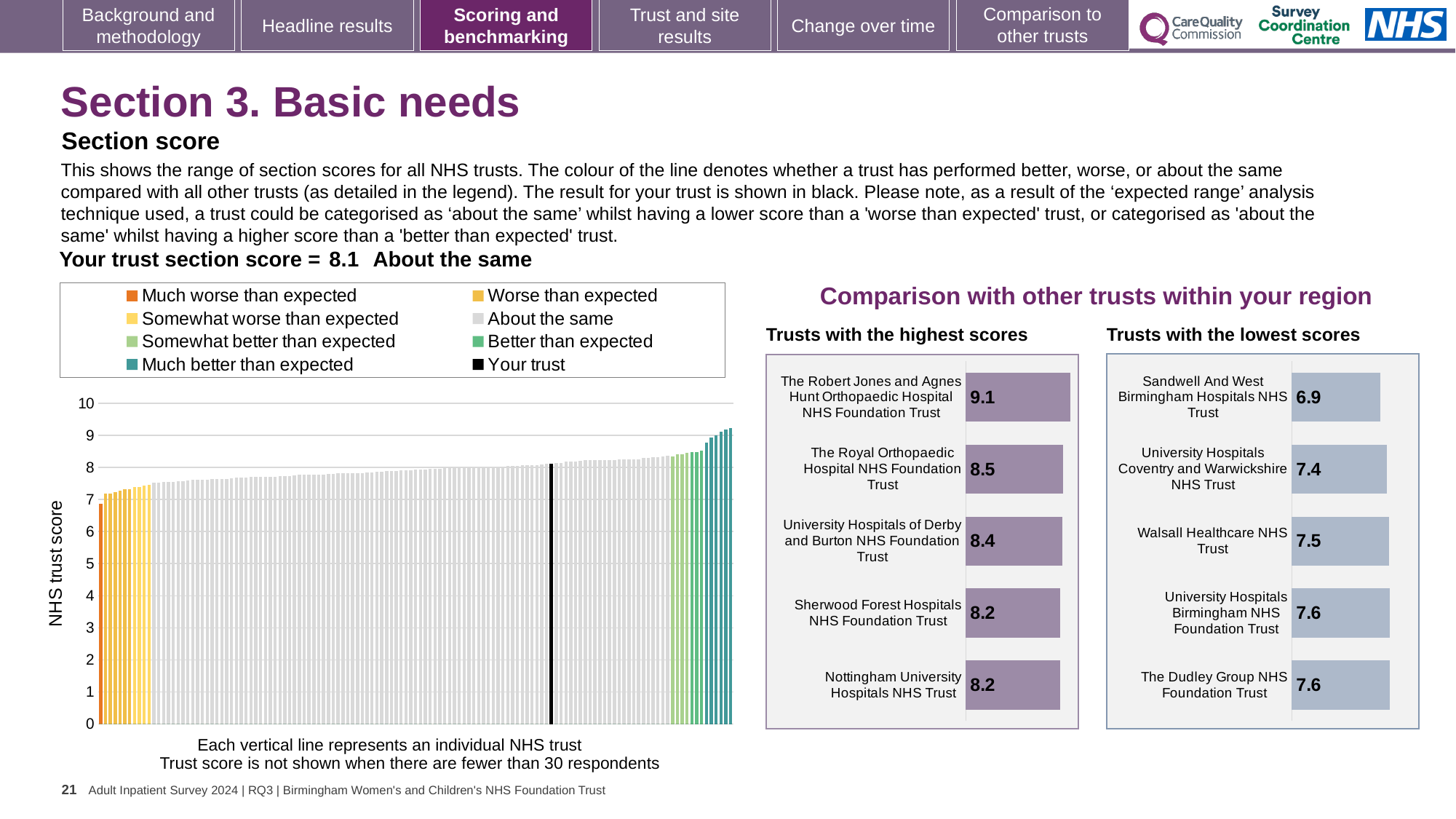
What is the difference between the score of The Robert Jones and Agnes Hunt Orthopaedic Hospital NHS Foundation Trust in the highest scores chart and Sandwell And West Birmingham Hospitals NHS Trust in the lowest scores chart? 2.2 In the 'Trusts with the lowest scores' chart, which has the higher score: Walsall Healthcare NHS Trust or University Hospitals Coventry and Warwickshire NHS Trust? Walsall Healthcare NHS Trust How many entries does the legend of the main NHS trust score chart list? 8 What kind of chart is the main chart showing NHS trust scores on the left of the slide? Bar chart In the main NHS trust score chart, do the bars rise or fall from left to right? Rise In the 'Trusts with the lowest scores' chart, which trust has the lowest score? Sandwell And West Birmingham Hospitals NHS Trust In the 'Trusts with the highest scores' chart, what is the difference between the scores of The Robert Jones and Agnes Hunt Orthopaedic Hospital NHS Foundation Trust and The Royal Orthopaedic Hospital NHS Foundation Trust? 0.6 In the main NHS trust score chart, is the value of the rightmost bar greater or less than 8? greater In the 'Trusts with the highest scores' chart, what is the score for The Robert Jones and Agnes Hunt Orthopaedic Hospital NHS Foundation Trust? 9.1 In the 'Trusts with the highest scores' chart, which trust has the highest score? The Robert Jones and Agnes Hunt Orthopaedic Hospital NHS Foundation Trust How many trusts are shown in the 'Trusts with the lowest scores' chart? 5 In the 'Trusts with the lowest scores' chart, what is the score for Sandwell And West Birmingham Hospitals NHS Trust? 6.9